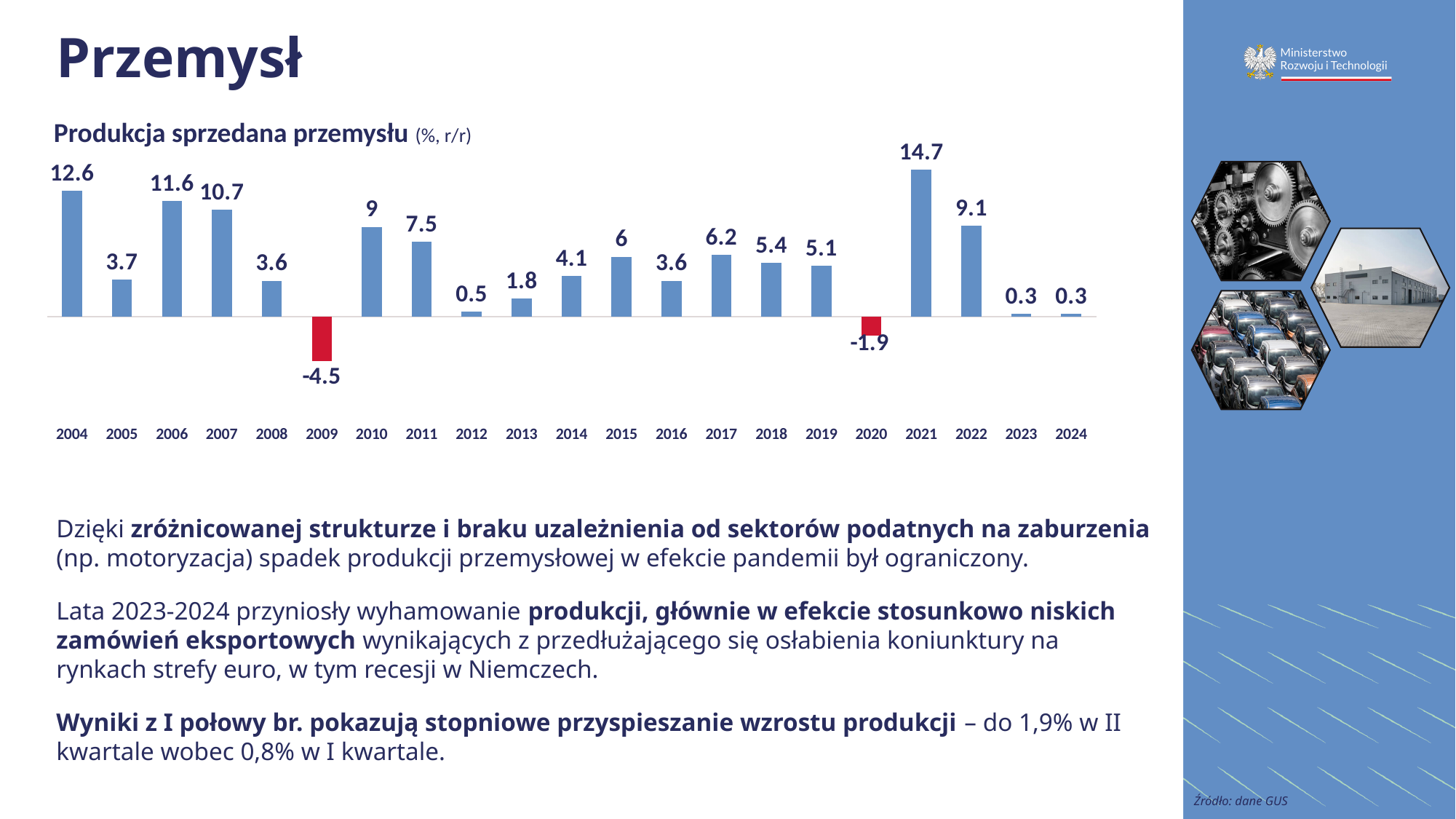
How many years are shown on the chart? 21 What is the difference between the values for 2021 and 2022? 5.6 What is the title of the chart? Produkcja sprzedana przemysłu (%, r/r) How many bars are coloured red? 2 What is the value for 2020? -1.9 Which year has the highest value? 2021 What is the value for 2009? -4.5 What is the value for 2021? 14.7 Do the values rise or fall from 2021 to 2024? fall What kind of chart is this? bar chart Which is larger, the value for 2004 or the value for 2006? 2004 Which year has the lowest value? 2009